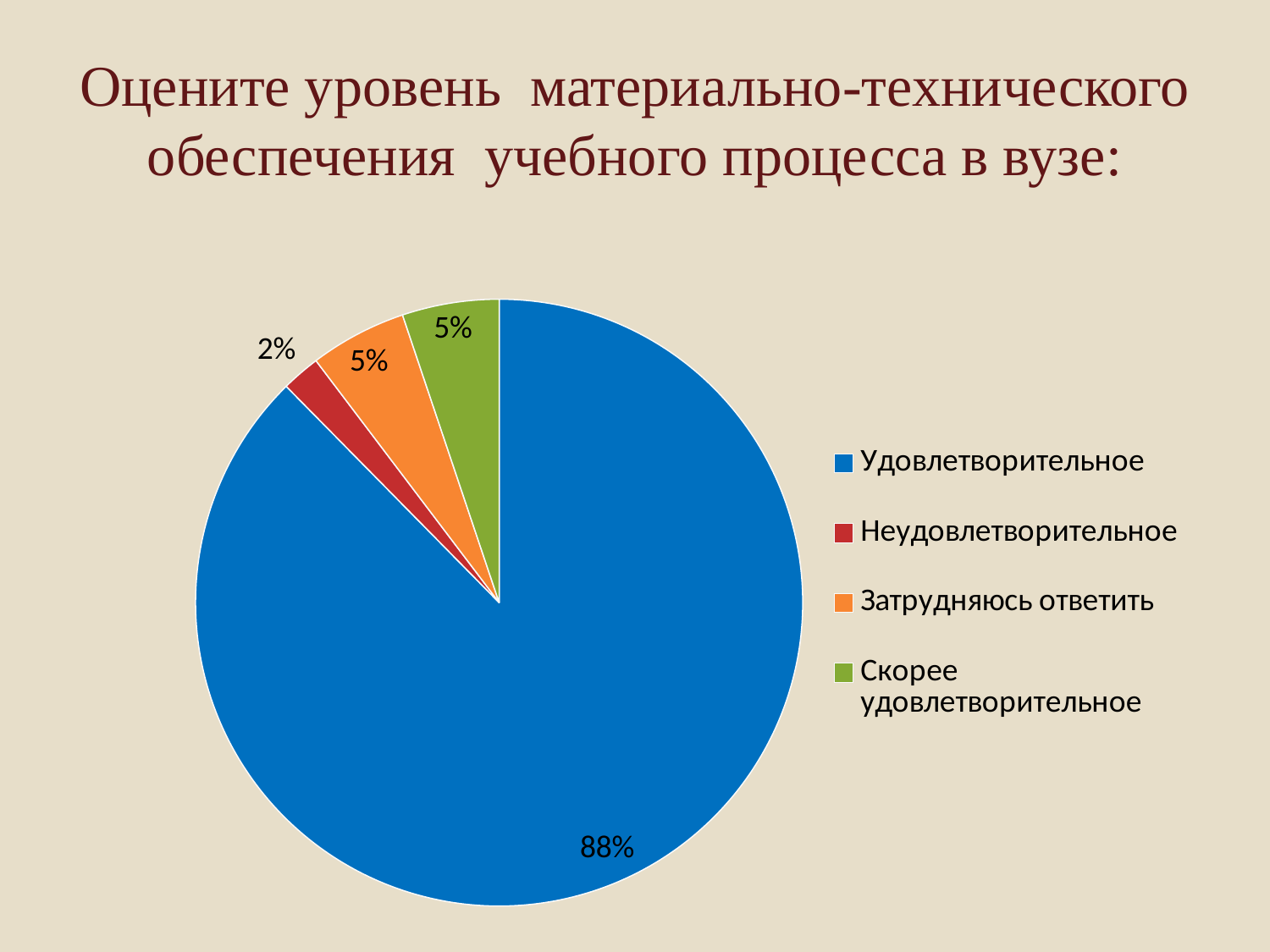
Which category has the smallest slice of the pie? Неудовлетворительное Which category has the largest slice of the pie? Удовлетворительное What share of the pie is labelled for Скорее удовлетворительное? 5% What is the difference between the shares for Удовлетворительное and Неудовлетворительное? 86% What kind of chart is shown on the slide? pie chart What share of the pie is labelled for Удовлетворительное? 88% How many slices does the pie chart have? 4 Which is larger, the share for Затрудняюсь ответить or the share for Неудовлетворительное? Затрудняюсь ответить What colour is the slice for Скорее удовлетворительное? green How many entries does the legend list? 4 What share of the pie is labelled for Неудовлетворительное? 2%